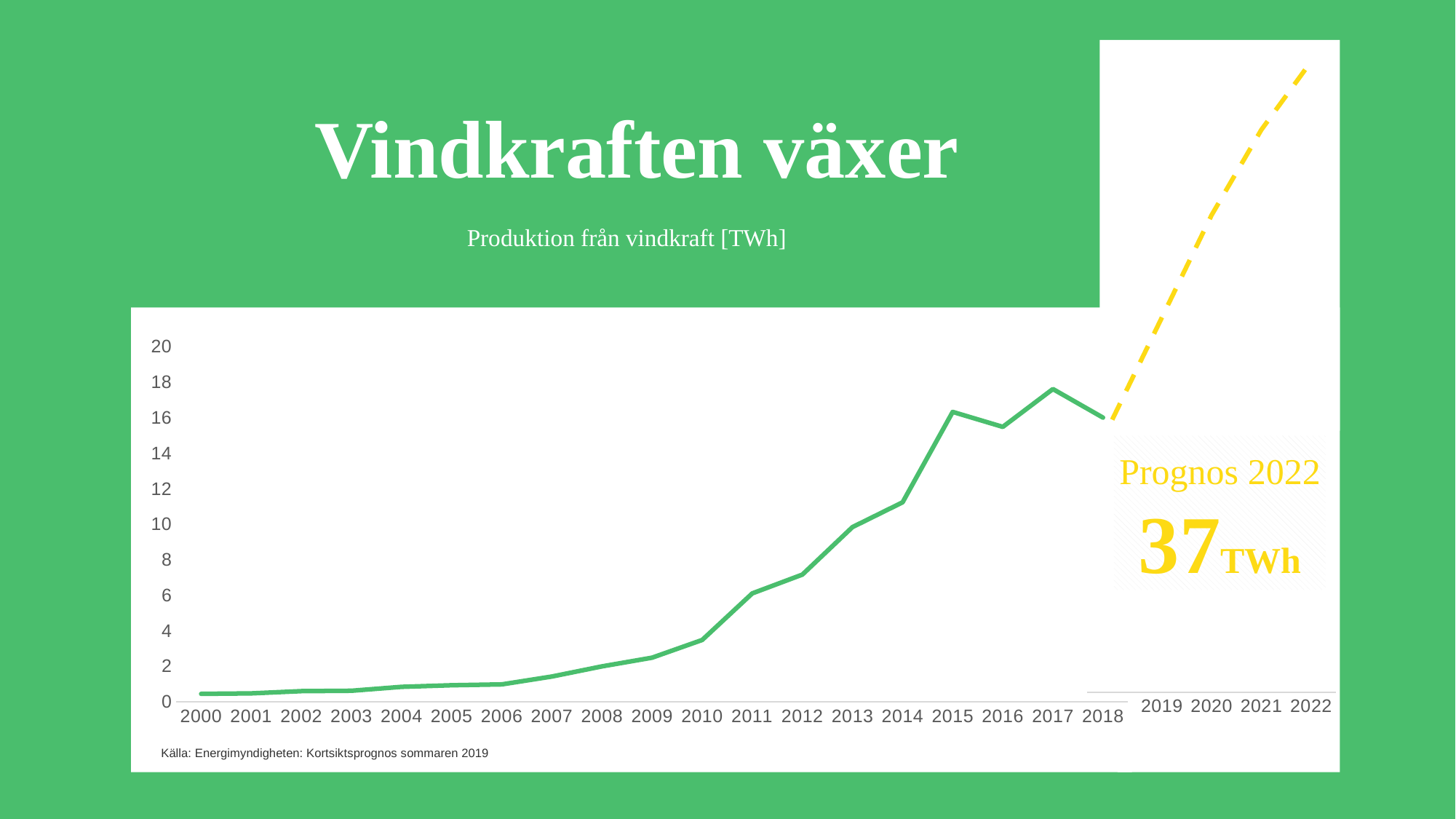
Is the value for 2012 greater or less than 8? less Which year between 2000 and 2018 has the lowest wind power production? 2000 What is the title of the chart? Produktion från vindkraft [TWh] What is the forecast (Prognos) value for wind power production in 2022? 37 TWh Which year between 2000 and 2018 has the highest wind power production? 2017 How many years of actual production data (solid line) are plotted, from 2000 to 2018? 19 Is the value for 2014 greater or less than 10? greater What kind of chart is shown on the slide? line chart Does wind power production generally rise or fall from 2000 to 2018? rise Which year has the higher wind power production, 2016 or 2017? 2017 Is the value for 2018 greater or less than 14? greater